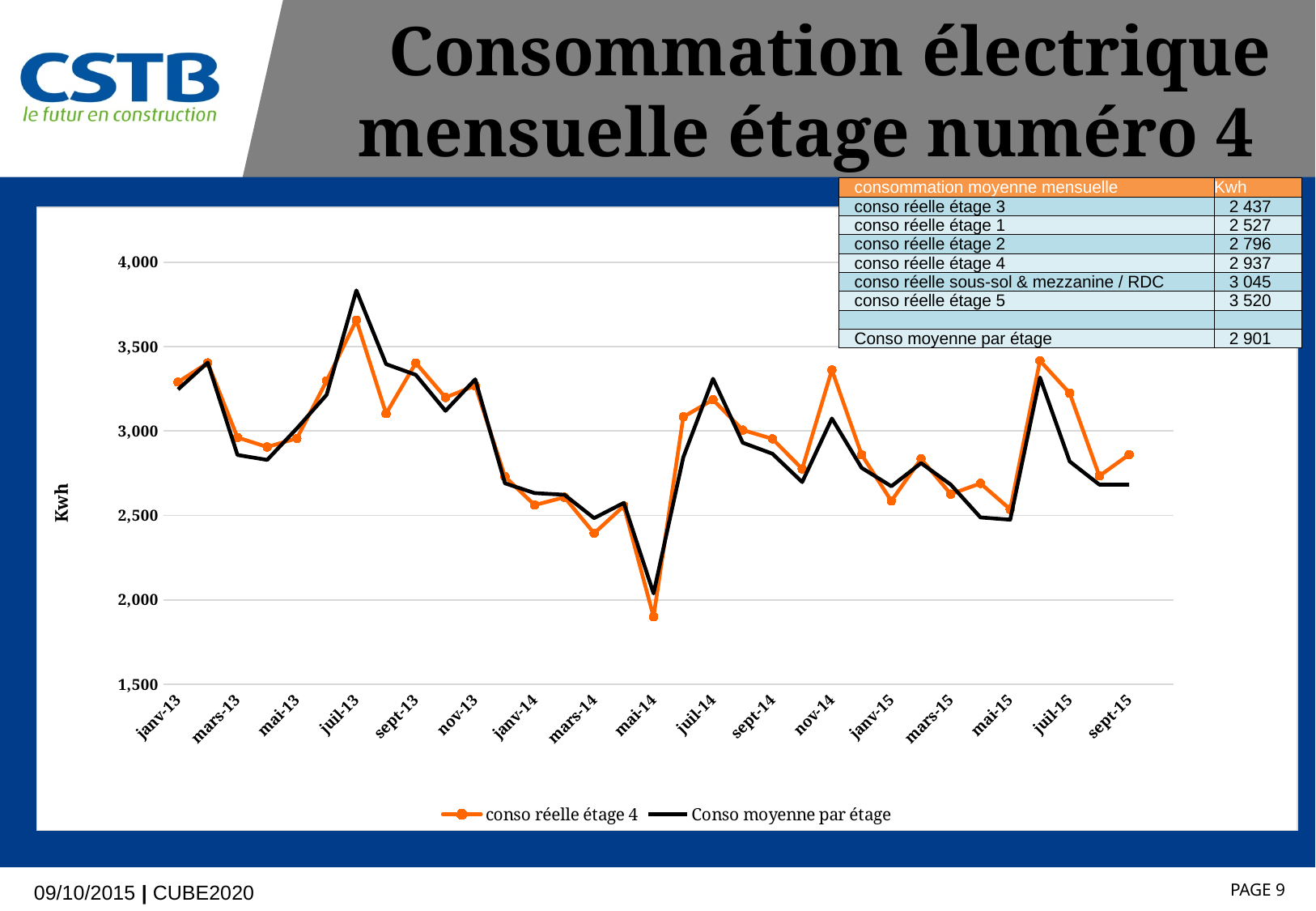
What are the two series named in the chart legend? conso réelle étage 4 and Conso moyenne par étage What unit is shown on the chart's vertical axis? Kwh Does the 'conso réelle étage 4' series rise or fall between mars-14 and mai-14? fall In juil-13, which series has the higher value: 'conso réelle étage 4' or 'Conso moyenne par étage'? Conso moyenne par étage In which month does the 'conso réelle étage 4' series reach its lowest value? mai-14 What kind of chart is shown on the slide? line chart Is the value of 'conso réelle étage 4' in mai-14 greater or less than 2,000? less In nov-14, which series has the higher value: 'conso réelle étage 4' or 'Conso moyenne par étage'? conso réelle étage 4 In which month does the 'Conso moyenne par étage' series reach its highest value? juil-13 In which month does the 'conso réelle étage 4' series reach its highest value? juil-13 Is the value of 'conso réelle étage 4' in juil-13 greater or less than 3,500? greater How many series does the chart legend list? 2